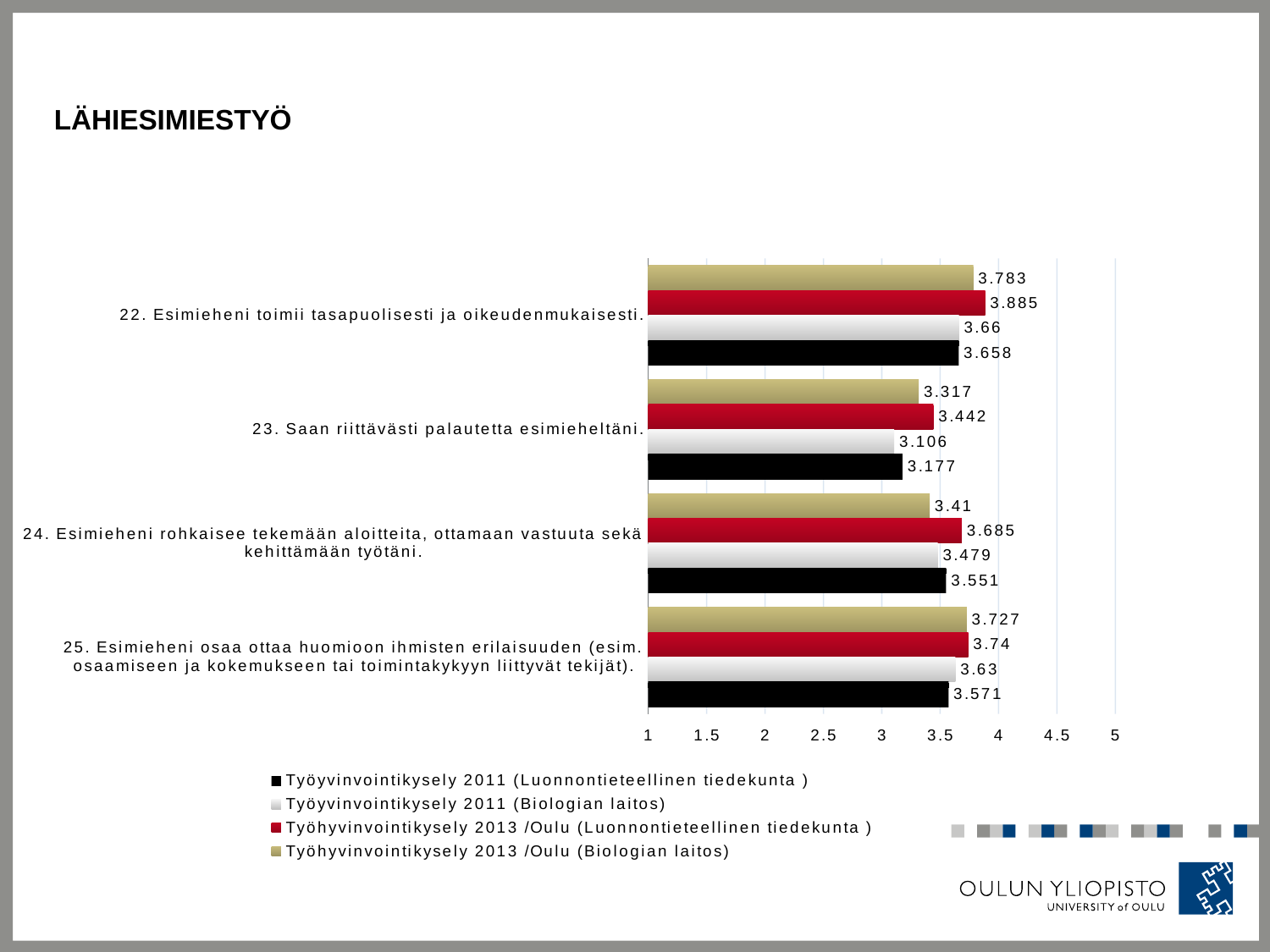
For question 24, which is larger: the Työhyvinvointikysely 2013 /Oulu (Biologian laitos) value or the Työyvinvointikysely 2011 (Biologian laitos) value? Työyvinvointikysely 2011 (Biologian laitos) What is the value for question 24 in the Työyvinvointikysely 2011 (Luonnontieteellinen tiedekunta) series? 3.551 Which question has the highest value in the Työhyvinvointikysely 2013 /Oulu (Luonnontieteellinen tiedekunta) series? 22. Esimieheni toimii tasapuolisesti ja oikeudenmukaisesti. What is the value for question 25 in the Työhyvinvointikysely 2013 /Oulu (Biologian laitos) series? 3.727 How many questions (categories) are shown on the chart? 4 What is the value for question 22 in the Työhyvinvointikysely 2013 /Oulu (Luonnontieteellinen tiedekunta) series? 3.885 What is the difference between the Työhyvinvointikysely 2013 /Oulu (Luonnontieteellinen tiedekunta) value and the Työyvinvointikysely 2011 (Luonnontieteellinen tiedekunta) value for question 23? 0.265 What is the value for question 23 in the Työyvinvointikysely 2011 (Biologian laitos) series? 3.106 How many series does the legend list? 4 What kind of chart is shown on the slide? bar chart Is the value for question 23 in the Työyvinvointikysely 2011 (Biologian laitos) series greater or less than 3.5? less Which question has the lowest value in the Työhyvinvointikysely 2013 /Oulu (Biologian laitos) series? 23. Saan riittävästi palautetta esimieheltäni.